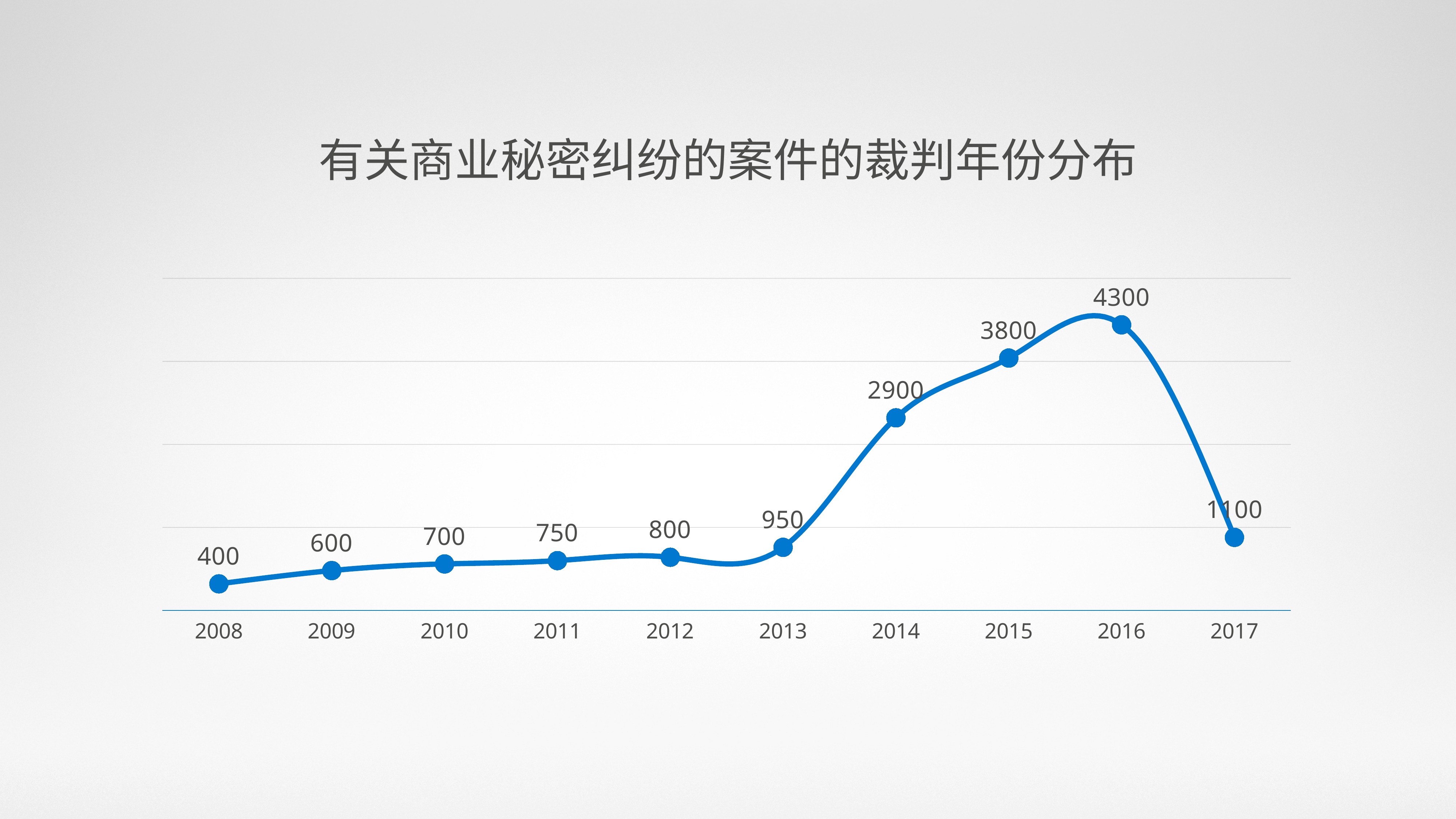
What is the difference between the values for 2015 and 2014? 900 Which year has the lowest value? 2008 Which year has the highest value? 2016 What is the value for 2008? 400 What is the difference between the values for 2016 and 2017? 3200 Do the values rise or fall from 2008 to 2016? rise Which is larger, the value for 2013 or the value for 2017? 2017 What is the value for 2014? 2900 What is the value for 2016? 4300 How many years are plotted on the chart? 10 What is the value for 2017? 1100 What kind of chart is this? line chart